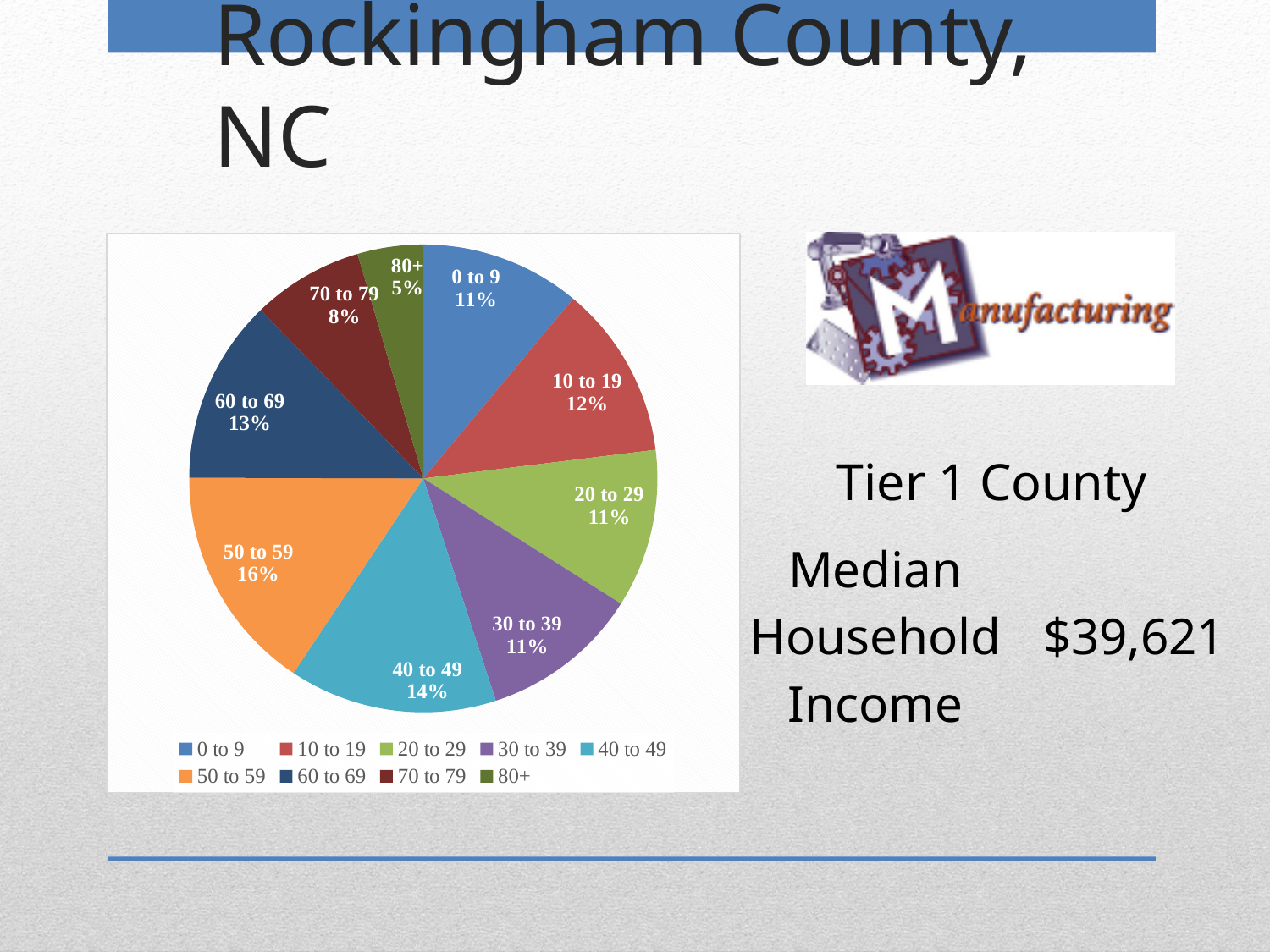
Which age group has the smallest slice of the pie? 80+ How many slices does the pie chart have? 9 What share of the pie does the 50 to 59 slice represent? 16% What is the value shown for the 80+ slice? 5% What is the difference in percentage points between the 50 to 59 slice and the 70 to 79 slice? 8 What kind of chart is shown on the slide? pie chart What is the value shown for the 40 to 49 slice? 14% What colour is the 50 to 59 slice? orange Which is larger, the 10 to 19 slice or the 60 to 69 slice? 60 to 69 Which age group has the largest slice of the pie? 50 to 59 What is the value shown for the 60 to 69 slice? 13% How many entries does the legend list? 9